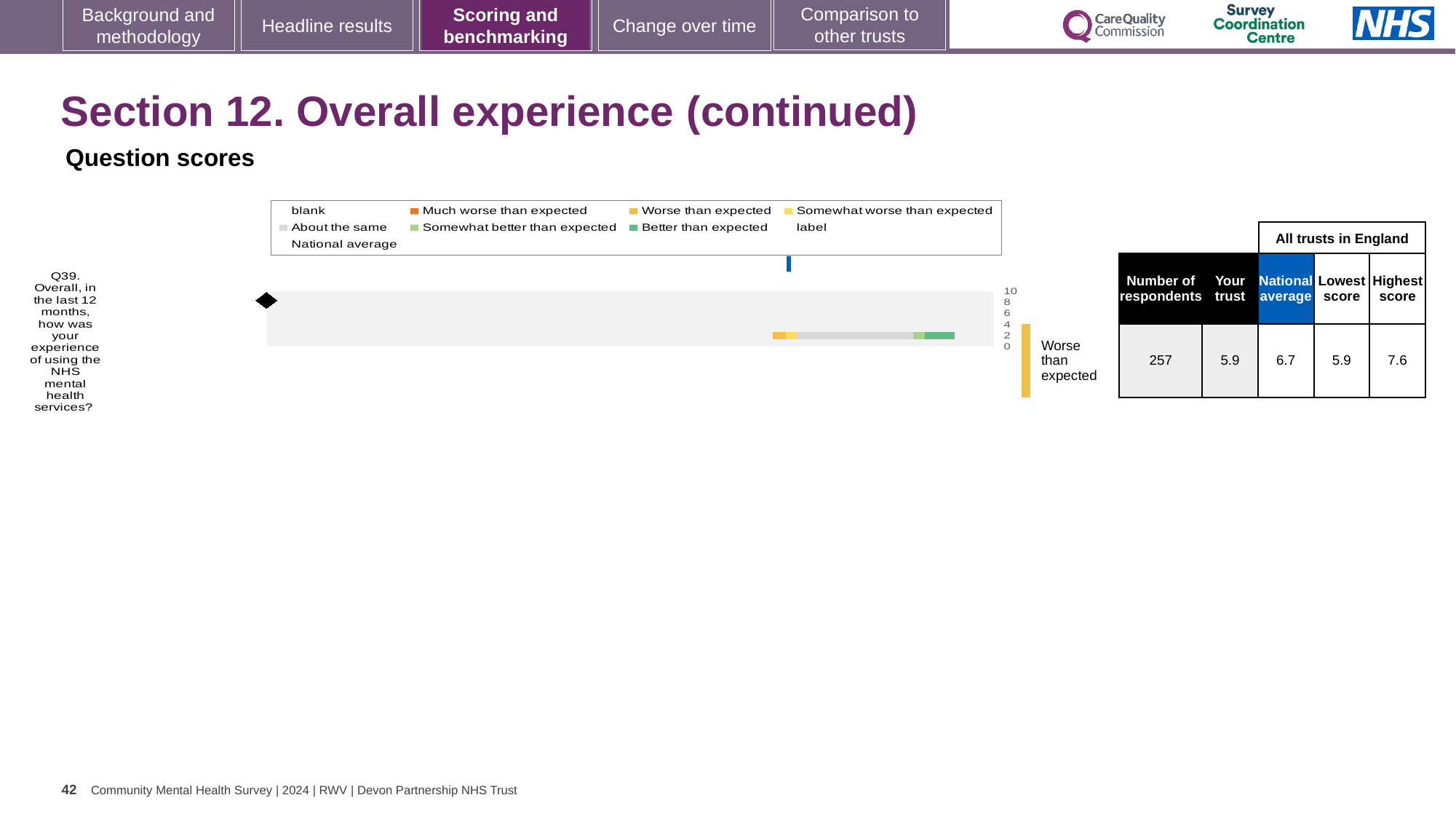
Which is larger for Q39, the 'Your trust' score or the national average? national average How many survey questions are plotted on the chart? 1 How many respondents answered Q39? 257 What rating label is shown to the right of the chart for Q39? Worse than expected What is the lowest score among all trusts in England for Q39? 5.9 What is the national average score for Q39? 6.7 What kind of chart is shown on the slide? bar chart What is the highest score among all trusts in England for Q39? 7.6 What is the highest value shown on the chart's axis? 10 What is the 'Your trust' score for Q39? 5.9 What is the difference between the national average and the 'Your trust' score for Q39? 0.8 Which question number is plotted on the chart? Q39